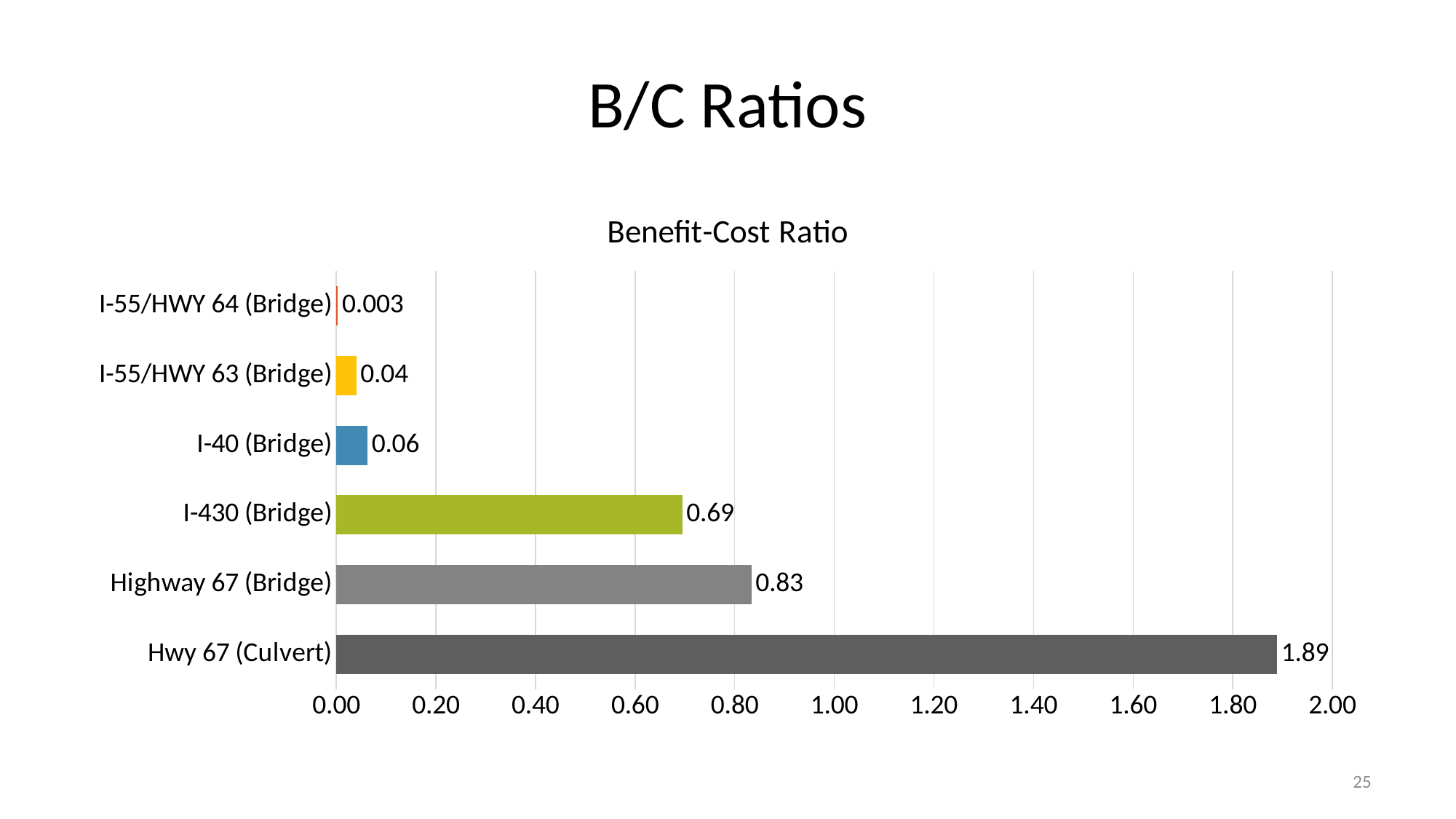
Is the Benefit-Cost Ratio for Highway 67 (Bridge) greater or less than 1.00? less What is the title of the chart? Benefit-Cost Ratio What type of chart is shown on the slide? Bar chart Which has a larger Benefit-Cost Ratio, I-430 (Bridge) or Highway 67 (Bridge)? Highway 67 (Bridge) What is the Benefit-Cost Ratio for Hwy 67 (Culvert)? 1.89 Which project has the highest Benefit-Cost Ratio? Hwy 67 (Culvert) How many projects are shown in the chart? 6 What is the difference between the Benefit-Cost Ratios of I-40 (Bridge) and I-55/HWY 63 (Bridge)? 0.02 What is the difference between the Benefit-Cost Ratios of Hwy 67 (Culvert) and Highway 67 (Bridge)? 1.06 What is the Benefit-Cost Ratio for I-430 (Bridge)? 0.69 Which project has the lowest Benefit-Cost Ratio? I-55/HWY 64 (Bridge) What is the Benefit-Cost Ratio for I-55/HWY 64 (Bridge)? 0.003